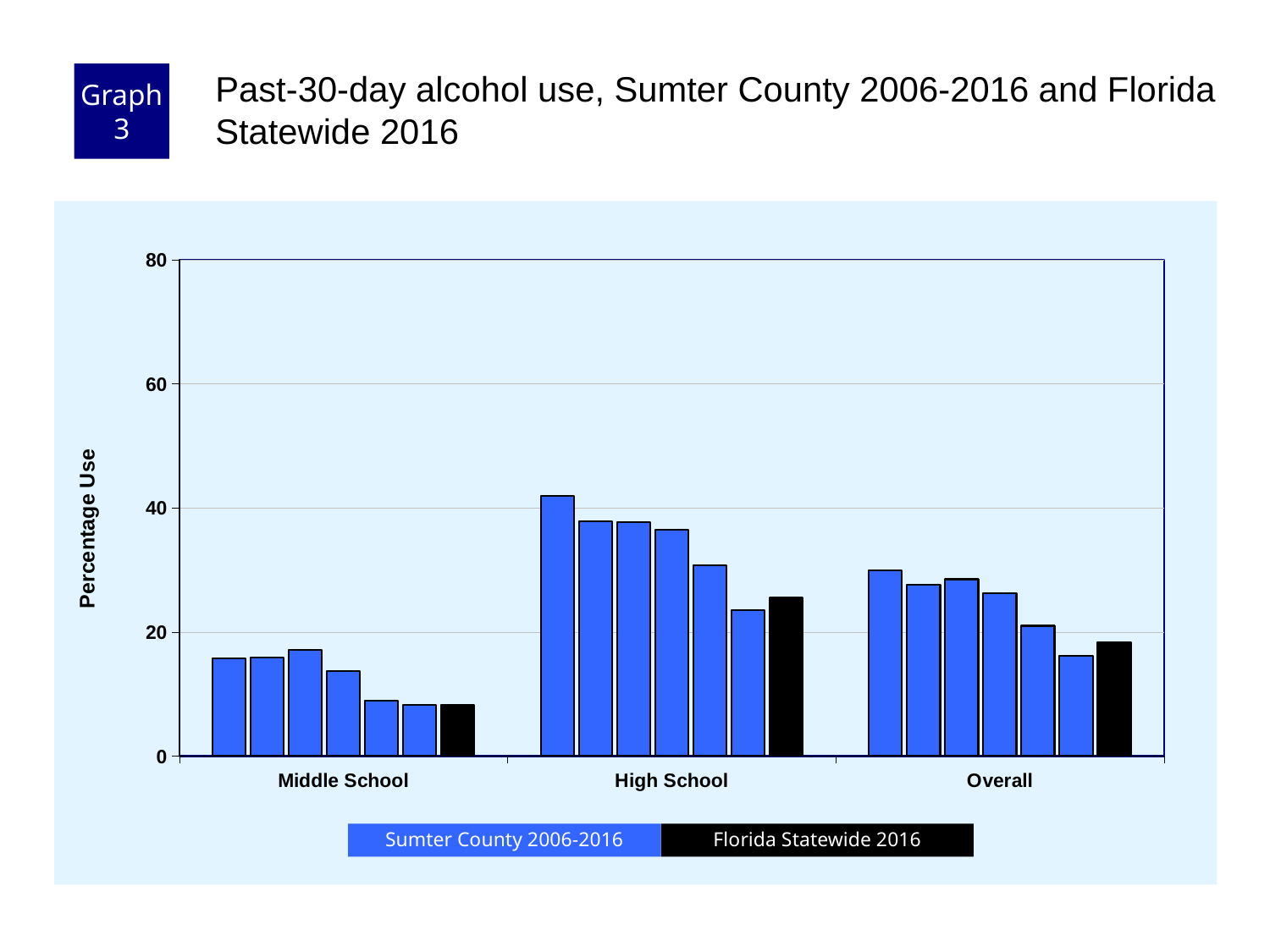
Which category has the highest bars overall? High School Is the Florida Statewide 2016 value for Middle School greater or less than 20? less Is the tallest Sumter County bar for High School greater or less than 40? greater Is the Florida Statewide 2016 value for High School greater or less than 20? greater What colour are the Florida Statewide 2016 bars? Black What is the label on the y axis? Percentage Use How many series does the legend list? 2 What kind of chart is shown on the slide? Bar chart Which category has the lowest bars overall? Middle School In the High School group, do the Sumter County 2006-2016 bars rise or fall from left to right? fall Which is larger: the Florida Statewide 2016 value for High School or for Middle School? High School How many categories are shown on the x axis? 3